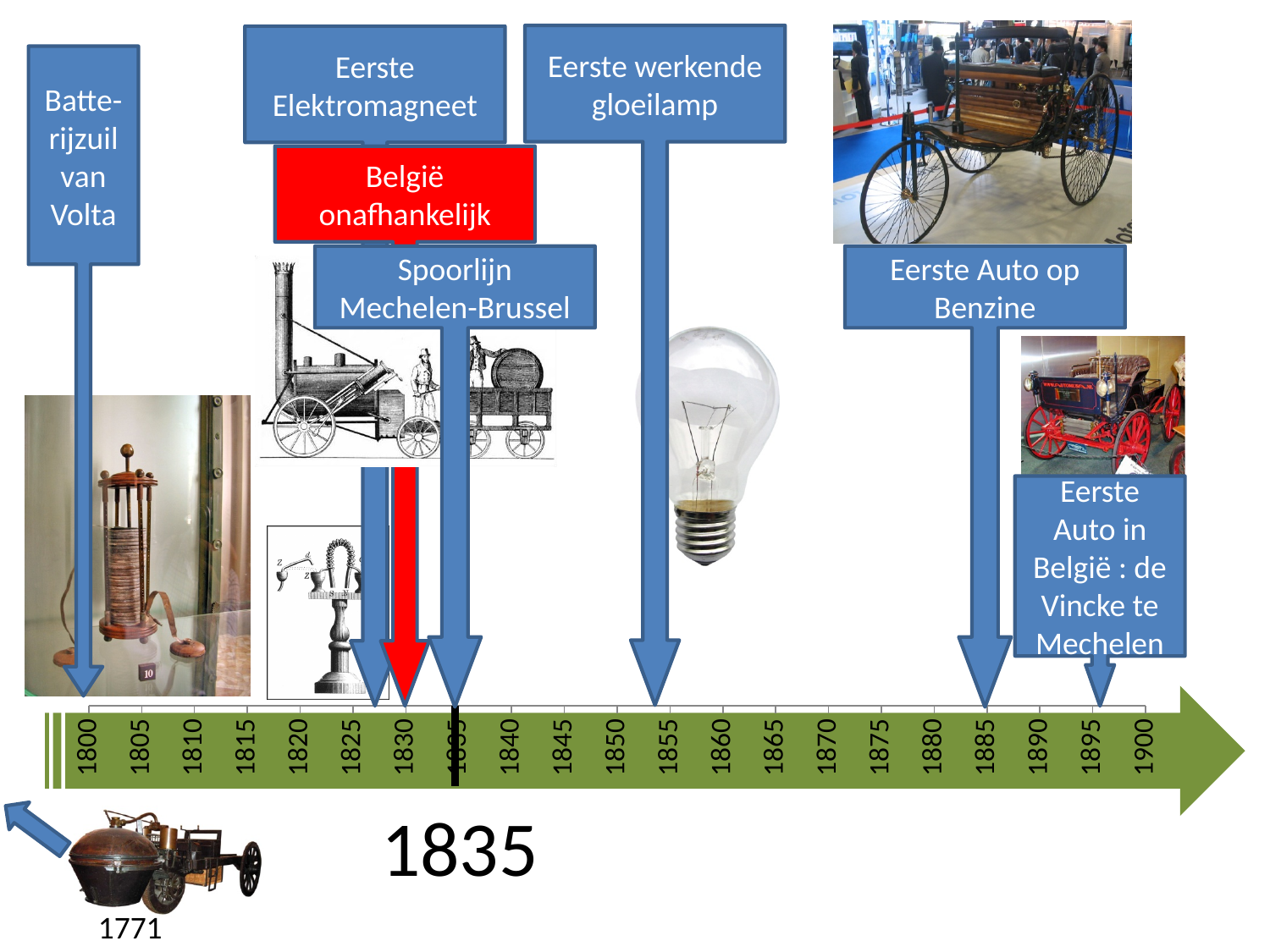
Which event comes earlier on the timeline: 'Batterijzuil van Volta' or 'Eerste werkende gloeilamp'? Batterijzuil van Volta Is 'Eerste Elektromagneet' placed before or after 1830 on the timeline? before How many labelled events point to the timeline axis? 7 According to the timeline, in which year was the Spoorlijn Mechelen-Brussel event placed? 1835 Is the 'Eerste werkende gloeilamp' placed before or after 1850 on the timeline? after What kind of visual is shown on the slide? A timeline What year is printed below the steam vehicle at the bottom left of the slide? 1771 What are the first and last year labels on the timeline axis? 1800 and 1900 Is 'Eerste Auto op Benzine' placed before or after 1880 on the timeline? after On which year tick does the arrow for 'Batterijzuil van Volta' land? 1800 On which year tick does the red arrow for 'België onafhankelijk' land? 1830 Which event label is shown in a red box instead of a blue one? België onafhankelijk